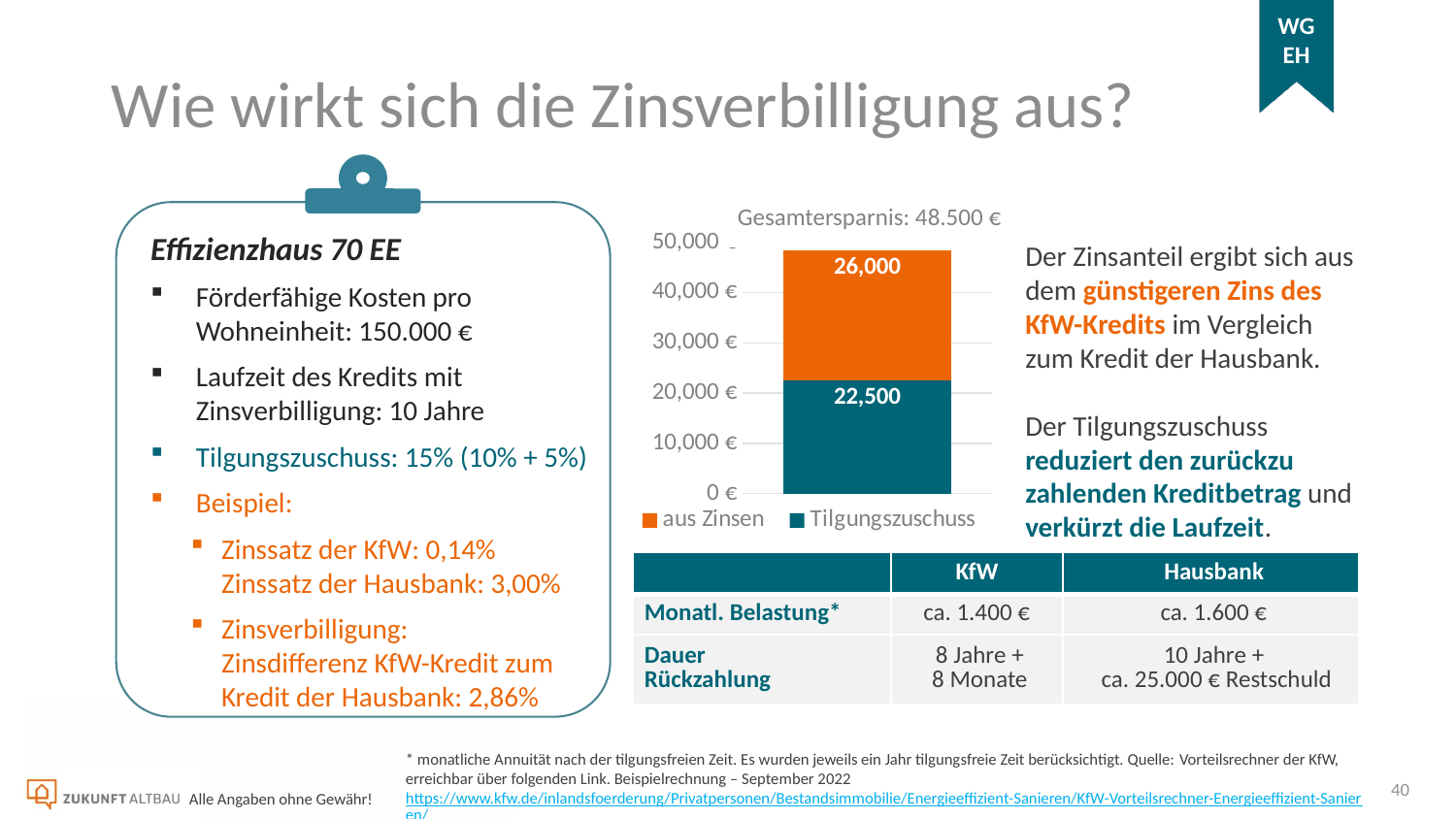
Is the "Tilgungszuschuss" segment greater or less than 30,000 €? less What is the total of the stacked bar in the chart? 48,500 What is the value of the "Tilgungszuschuss" segment in the stacked bar chart? 22,500 What type of chart is shown on the slide? Stacked bar chart Which series has the larger value in the stacked bar chart, "aus Zinsen" or "Tilgungszuschuss"? aus Zinsen What is the title of the chart? Gesamtersparnis: 48.500 € How many bars are plotted in the chart? 1 Which colour represents the "Tilgungszuschuss" series in the chart? Teal How many series does the chart legend list? 2 What is the difference between the "aus Zinsen" value and the "Tilgungszuschuss" value in the chart? 3,500 What is the value of the "aus Zinsen" segment in the stacked bar chart? 26,000 Is the total height of the stacked bar greater or less than 40,000 €? greater